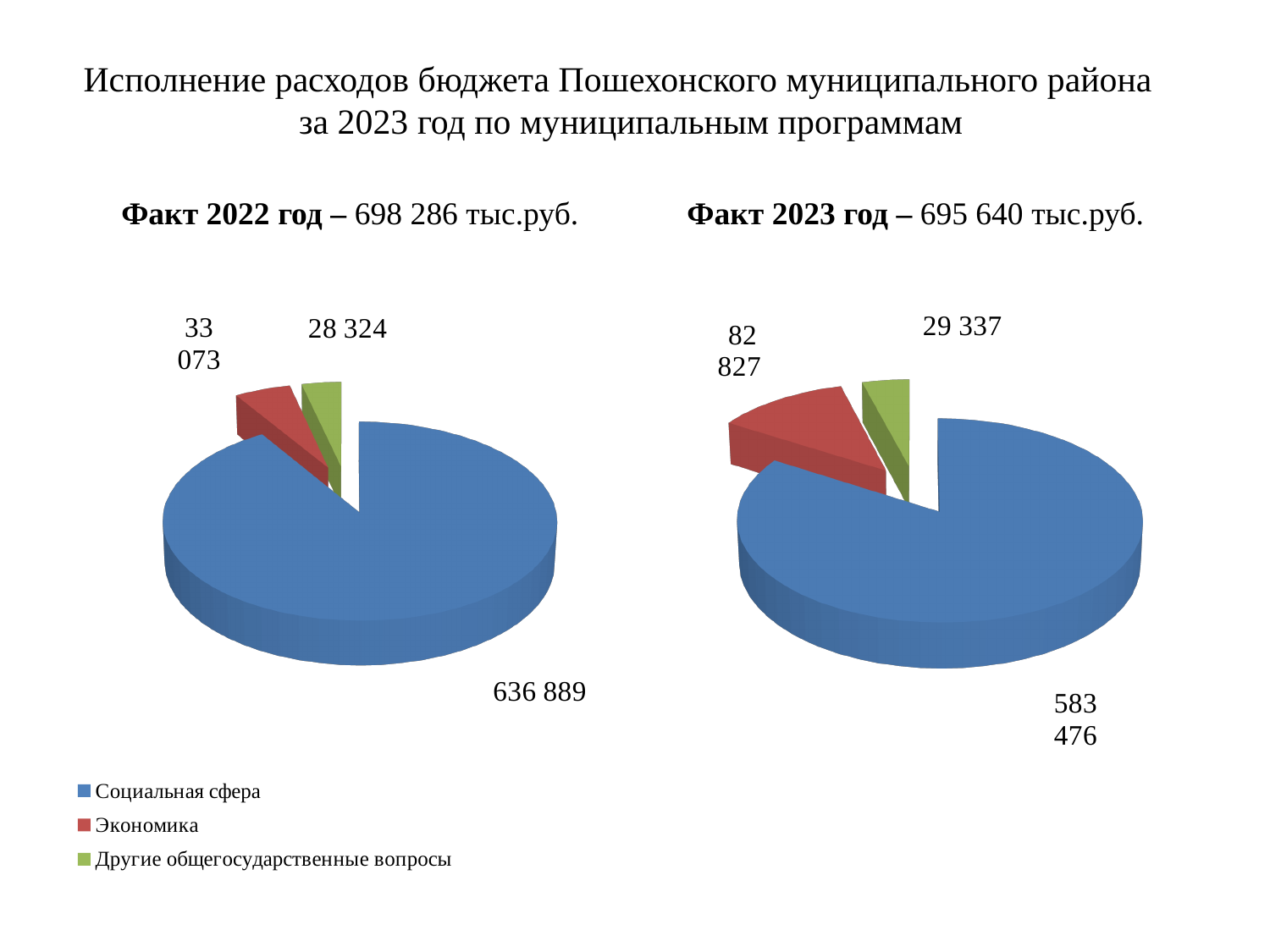
In the 'Факт 2023 год' pie chart, what is the value for Социальная сфера? 583 476 How many slices does the 'Факт 2023 год' pie chart have? 3 What is the difference between Экономика in the 'Факт 2023 год' chart and Экономика in the 'Факт 2022 год' chart? 49 754 In the 'Факт 2022 год' pie chart, which category has the smallest slice? Другие общегосударственные вопросы In the 'Факт 2023 год' pie chart, what is the value for Экономика? 82 827 What type of chart is used on this slide? Pie chart By how much does the value for Социальная сфера in the 'Факт 2022 год' chart exceed the value for Социальная сфера in the 'Факт 2023 год' chart? 53 413 In the 'Факт 2022 год' pie chart, what is the value for Другие общегосударственные вопросы? 28 324 Which colour represents Экономика in the legend? Red Which is larger: Экономика in the 'Факт 2022 год' chart or Экономика in the 'Факт 2023 год' chart? Факт 2023 год In the 'Факт 2023 год' pie chart, which category has the largest slice? Социальная сфера In the 'Факт 2022 год' pie chart, what is the value for Социальная сфера? 636 889